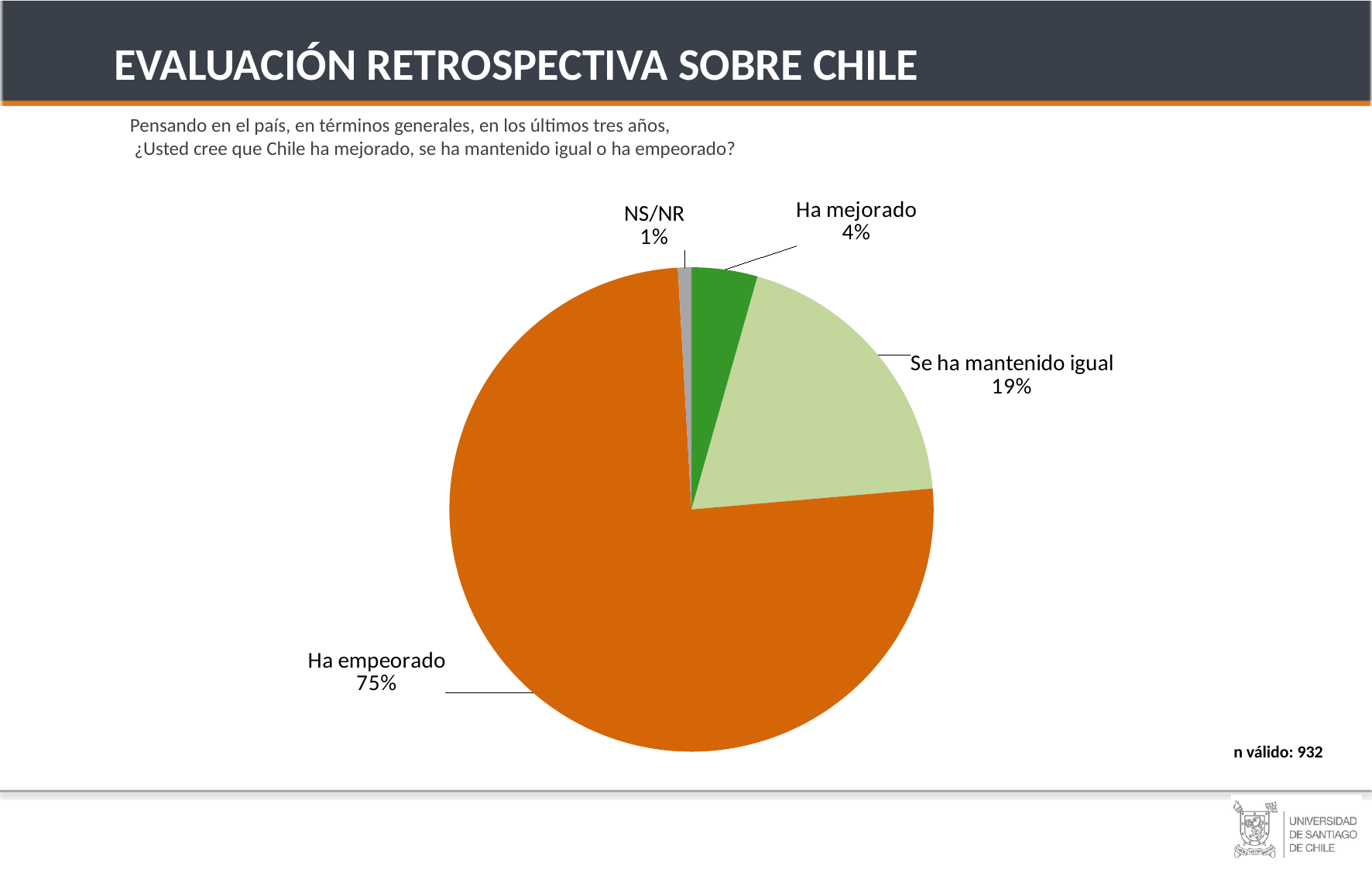
Which category has the smallest share of the pie? NS/NR Which is larger, the share for "Ha mejorado" or the share for "Se ha mantenido igual"? Se ha mantenido igual What colour is the "Ha empeorado" slice? orange What percentage of respondents said "Ha empeorado"? 75% What is the difference in percentage points between "Ha empeorado" and "Se ha mantenido igual"? 56 What percentage of respondents said "Se ha mantenido igual"? 19% What kind of chart is shown on the slide? pie chart Which category has the largest share of the pie? Ha empeorado What percentage of respondents said "Ha mejorado"? 4% What is the valid sample size (n válido) shown on the slide? 932 What percentage is shown for "NS/NR"? 1% How many categories are shown in the pie chart? 4